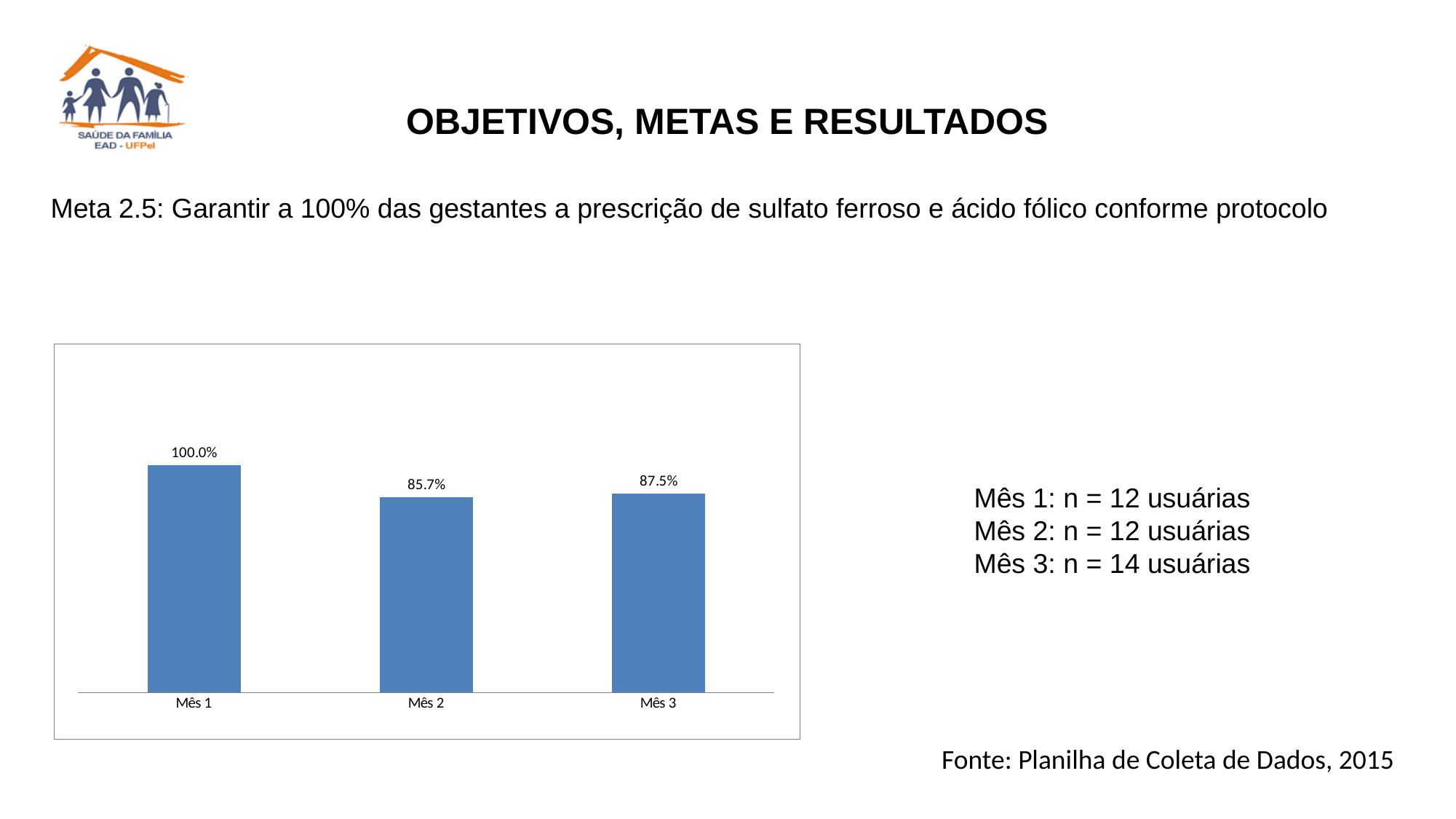
How many bars are shown in the chart? 3 Which month has the highest value? Mês 1 What is the value for Mês 2? 85.7% What is the difference between the values for Mês 3 and Mês 2? 1.8% What is the value for Mês 1? 100.0% What kind of chart is shown on the slide? Bar chart Which is larger, the value for Mês 1 or the value for Mês 3? Mês 1 Does the value rise or fall from Mês 1 to Mês 2? Fall Which month has the lowest value? Mês 2 What colour are the bars in the chart? Blue What is the difference between the values for Mês 1 and Mês 2? 14.3% What is the value for Mês 3? 87.5%